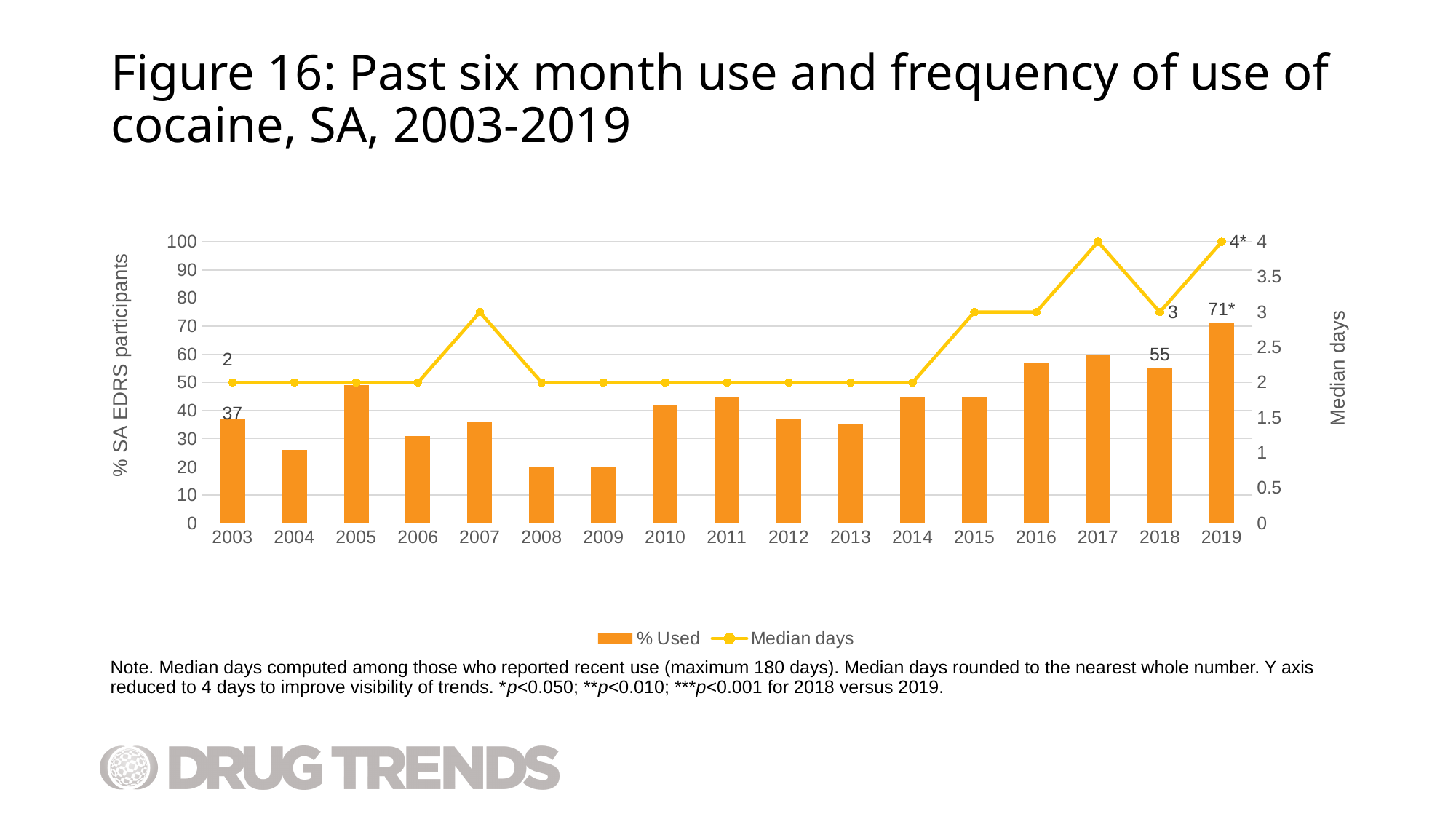
What is the % Used value for 2018? 55 What is the Median days value for 2003? 2 By how many percentage points did % Used increase from 2018 to 2019? 16 What is the % Used value for 2003? 37 What is the Median days value for 2018? 3 Which year has the larger % Used, 2005 or 2006? 2005 How many series does the legend list? 2 Is the % Used value for 2008 greater or less than 30? less How many years are shown on the x axis? 17 What kind of chart is this? Combined bar and line chart What is the % Used value labelled for 2019? 71* Which year has the highest % Used? 2019